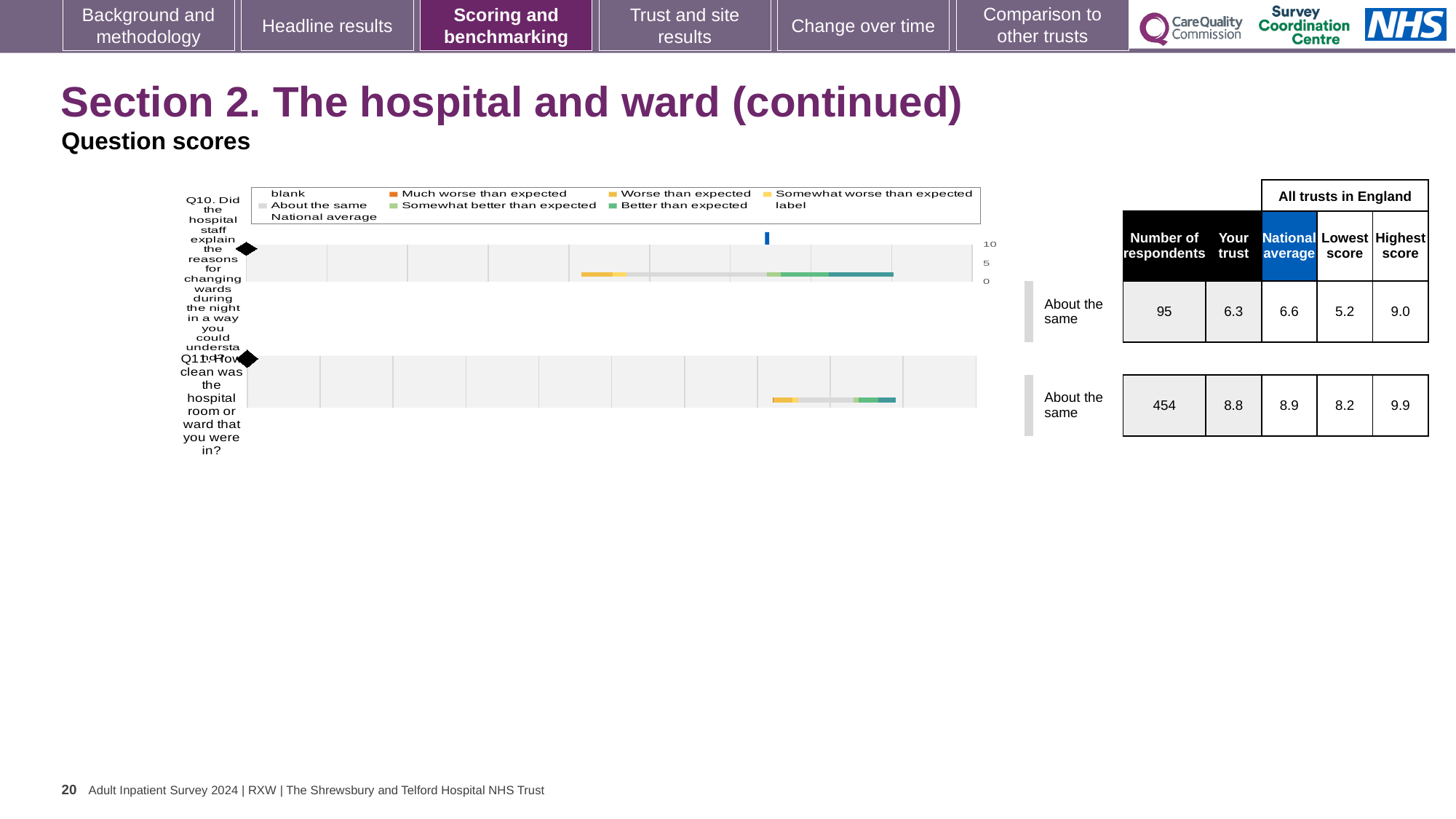
What is the highest score among all trusts in England for Q11? 9.9 What benchmark category is shown for Q10? About the same What is the national average score for Q10? 6.6 Which question has the higher 'Your trust' score, Q10 or Q11? Q11 What is the 'Your trust' score for Q11 (how clean was the hospital room or ward)? 8.8 What is the lowest score among all trusts in England for Q10? 5.2 What kind of chart is used to show the question scores? Bar chart How many respondents answered Q11? 454 How many respondents answered Q10? 95 What is the national average score for Q11? 8.9 By how much does the national average for Q10 exceed the trust's score for Q10? 0.3 What is the 'Your trust' score for Q10 (explaining reasons for changing wards during the night)? 6.3